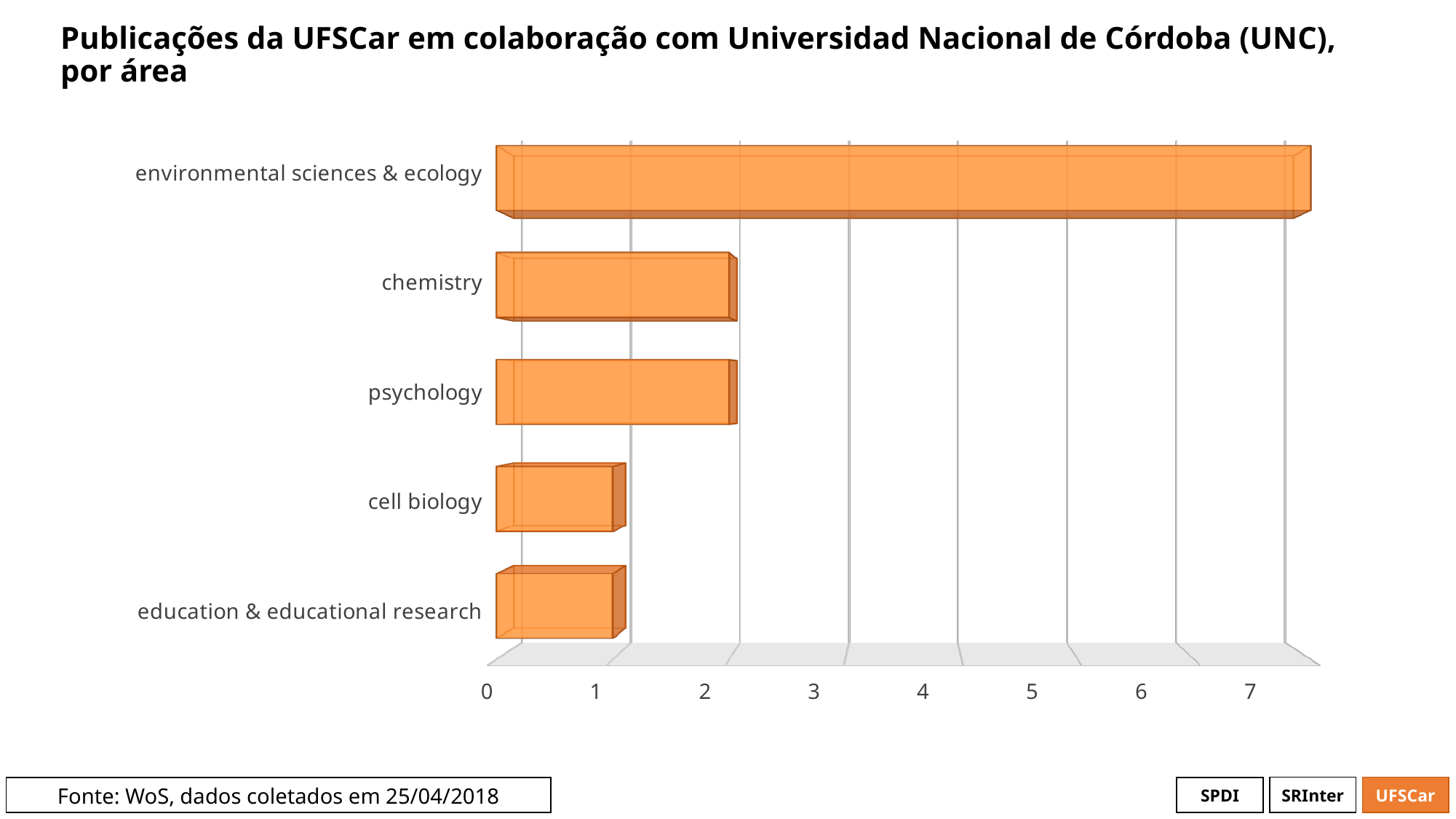
What is the difference between the value for chemistry and the value for cell biology? 1 Which is larger, the value for chemistry or the value for cell biology? chemistry What is the value for education & educational research? 1 What is the value for cell biology? 1 Is the value for environmental sciences & ecology greater or less than 6? greater What kind of chart is shown on the slide? bar chart How many areas (categories) are shown in the chart? 5 What is the title of the chart? Publicações da UFSCar em colaboração com Universidad Nacional de Córdoba (UNC), por área What is the value for chemistry? 2 What is the value for psychology? 2 Which area has the highest number of publications? environmental sciences & ecology